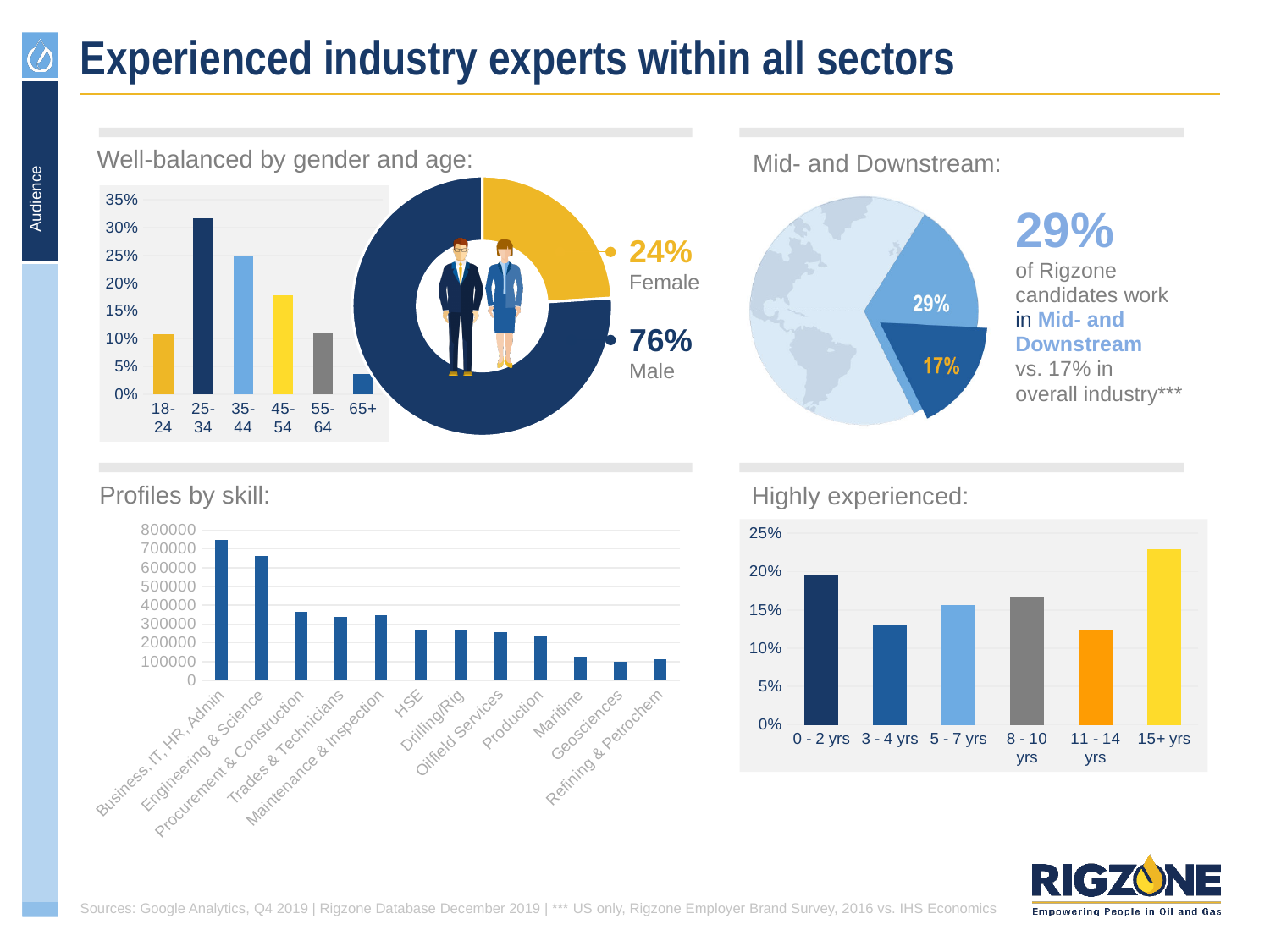
In the age bar chart under 'Well-balanced by gender and age', how many age groups are shown? 6 In the 'Profiles by skill' chart, which skill category has the highest value? Business, IT, HR, Admin In the 'Highly experienced' chart, which experience group has the highest value? 15+ yrs In the 'Profiles by skill' chart, how many skill categories are shown? 12 In the 'Well-balanced by gender and age' donut chart, what percentage is Male? 76% In the age bar chart under 'Well-balanced by gender and age', which age group has the lowest value? 65+ In the age bar chart under 'Well-balanced by gender and age', is the value for 45-54 greater or less than 15%? greater In the 'Mid- and Downstream' pie chart, what is the percentage for the overall industry? 17% In the age bar chart under 'Well-balanced by gender and age', which age group has the highest value? 25-34 In the 'Well-balanced by gender and age' donut chart, what is the difference between the Male and Female percentages? 52% In the 'Well-balanced by gender and age' donut chart, what percentage is Female? 24% In the 'Mid- and Downstream' pie chart, what percentage of Rigzone candidates work in Mid- and Downstream? 29%